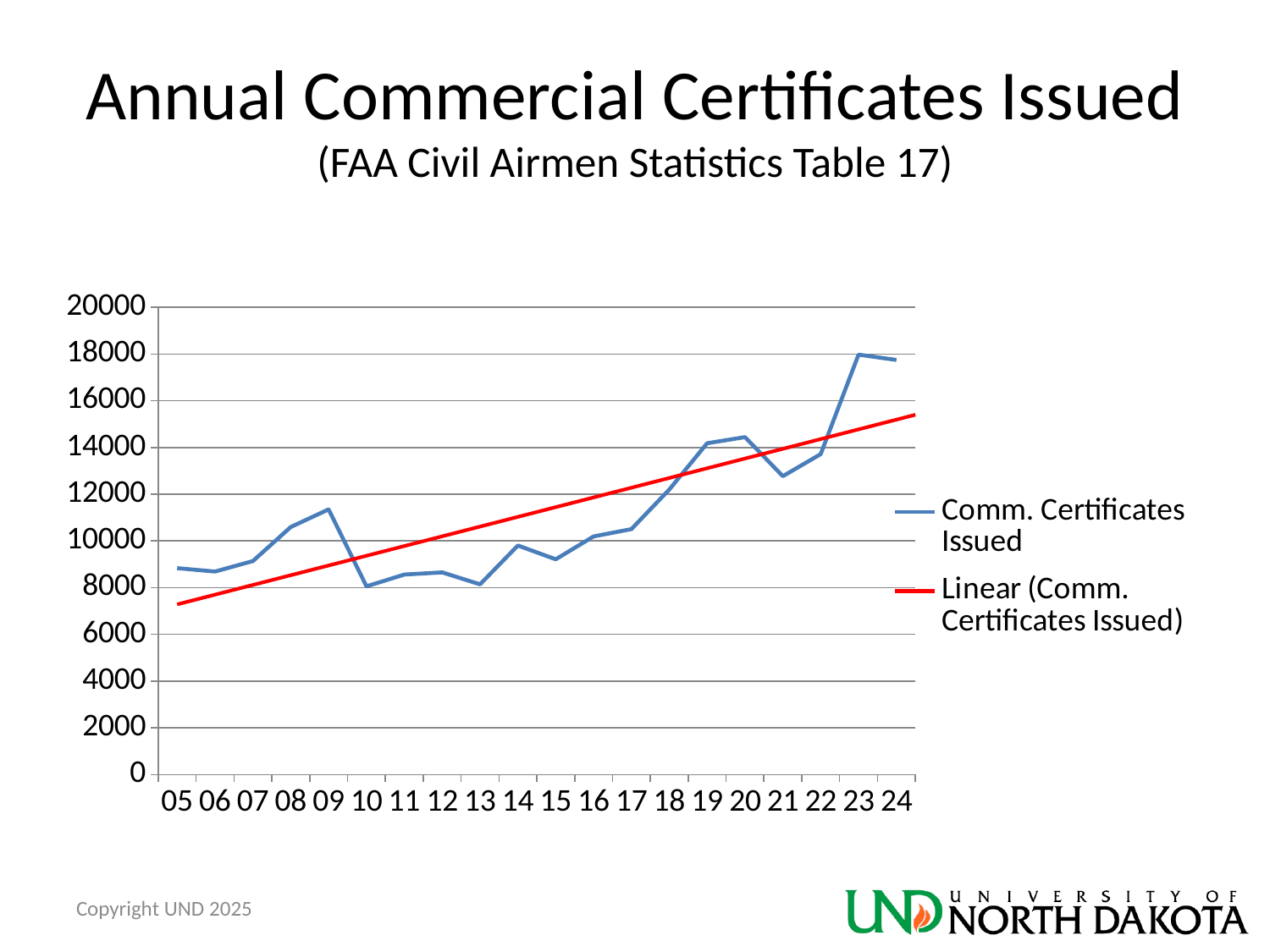
Is the value for Comm. Certificates Issued in 10 greater or less than 10000? less How many series does the legend list? 2 In which year were the most commercial certificates issued? 23 How many years are plotted along the x axis? 20 Which year has the larger value for Comm. Certificates Issued, 09 or 10? 09 What kind of chart is shown on the slide? line chart Is the value for Comm. Certificates Issued in 09 greater or less than 10000? greater What colour is the Linear (Comm. Certificates Issued) line? red Which year has the larger value for Comm. Certificates Issued, 20 or 21? 20 Is the value for Comm. Certificates Issued in 23 greater or less than 16000? greater Does the linear trend line rise or fall from 05 to 24? rises